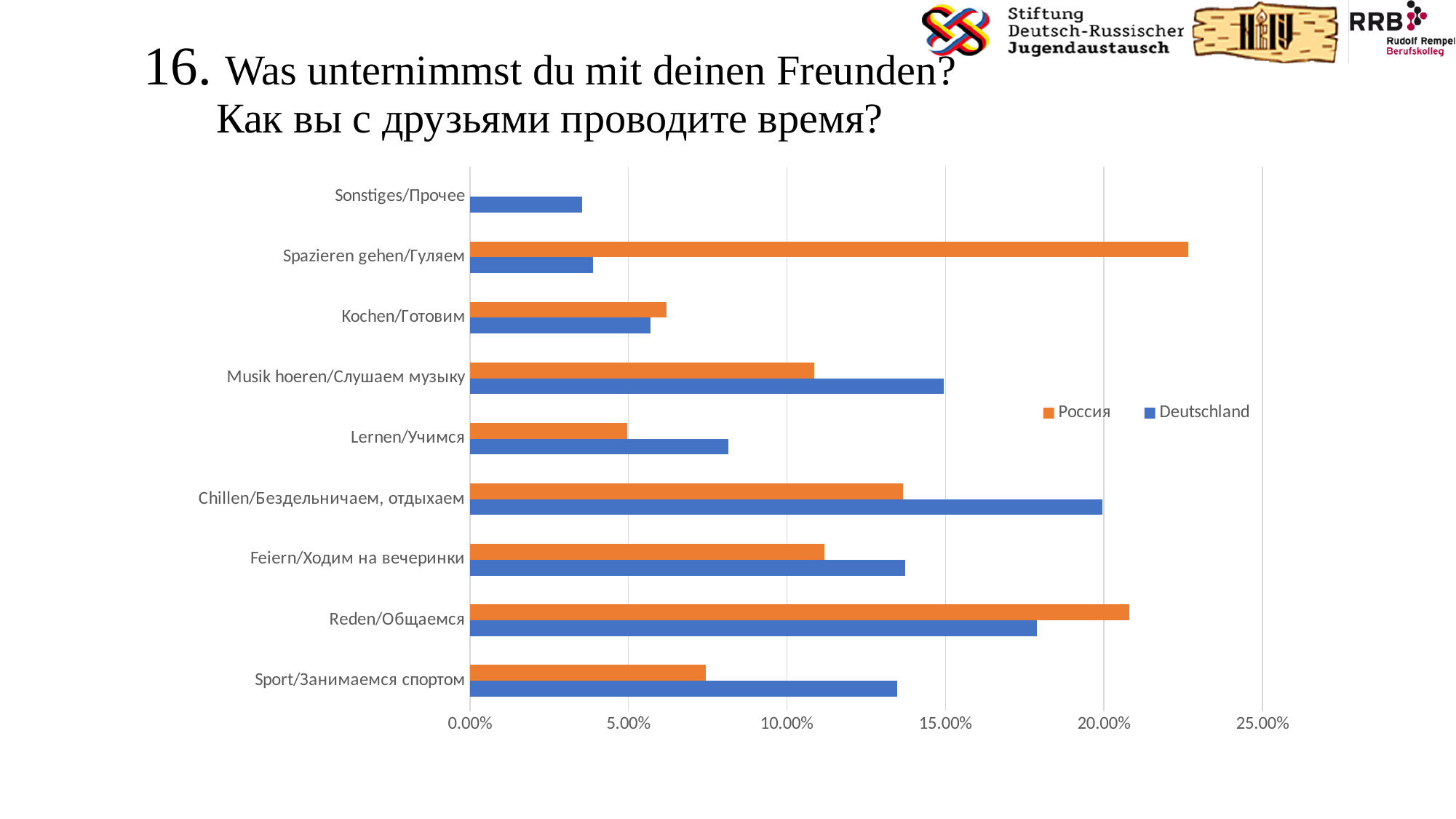
Which colour represents the Россия series in the chart? orange Which colour represents the Deutschland series in the chart? blue How many categories are shown on the chart? 9 For Musik hoeren/Слушаем музыку, which series has the larger value, Россия or Deutschland? Deutschland Is the value for Sport/Занимаемся спортом for Deutschland greater or less than 10.00%? greater Is the value for Spazieren gehen/Гуляем for Россия greater or less than 20.00%? greater For Reden/Общаемся, which series has the larger value, Россия or Deutschland? Россия Which category has the highest value for Россия? Spazieren gehen/Гуляем What kind of chart is shown on the slide? bar chart Is the value for Lernen/Учимся for Россия greater or less than 10.00%? less How many series does the legend list? 2 Which category has the highest value for Deutschland? Chillen/Бездельничаем, отдыхаем